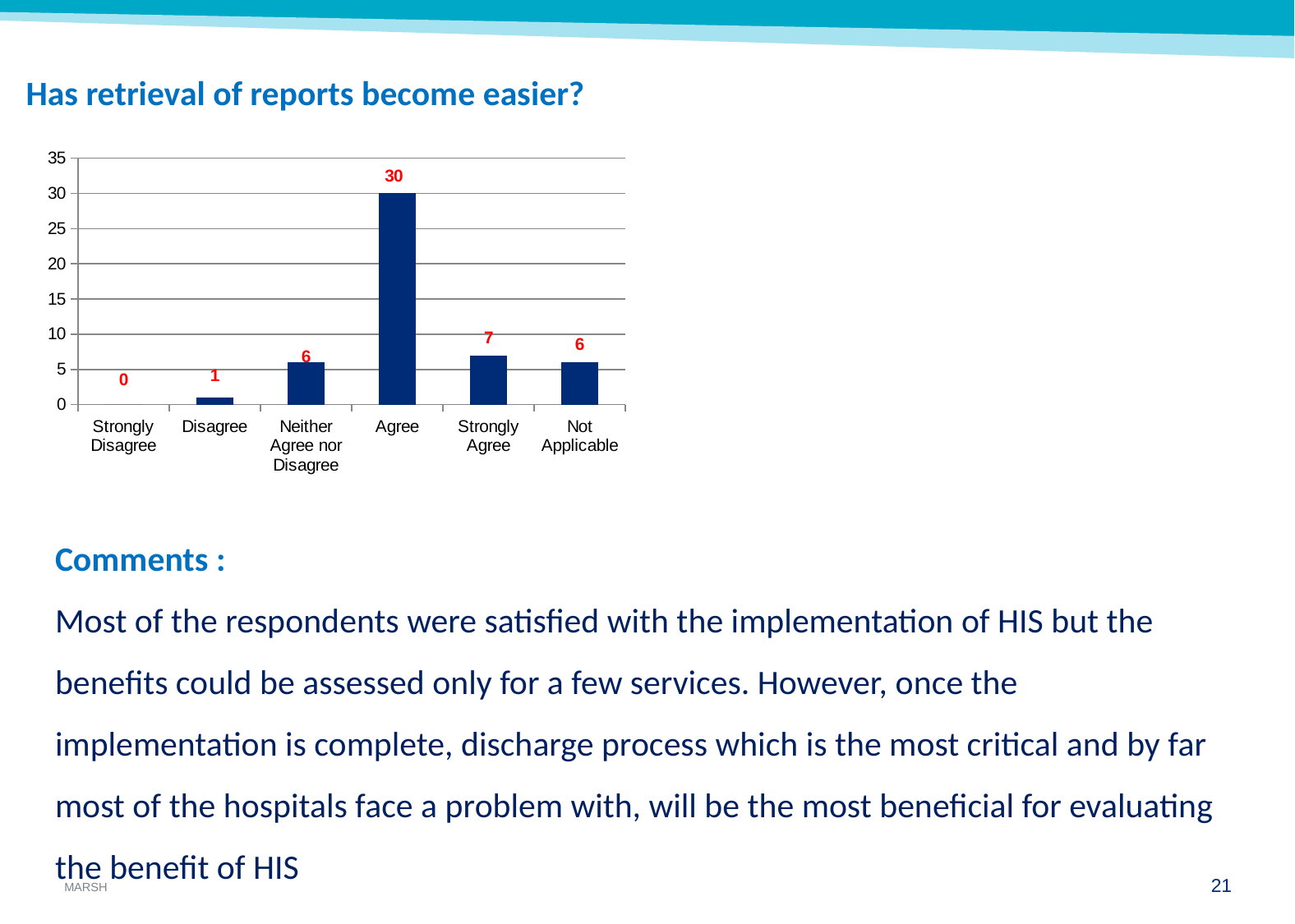
What is the difference between the values for Agree and Strongly Agree? 23 What is the value for Strongly Agree? 7 Which category has the highest value? Agree What is the value for Disagree? 1 Is the value for Agree greater or less than 25? greater Which is larger, the value for Strongly Agree or the value for Neither Agree nor Disagree? Strongly Agree What kind of chart is shown on the slide? bar chart What is the value for Agree? 30 What is the value for Strongly Disagree? 0 How many categories are shown on the x axis? 6 What is the value for Not Applicable? 6 Which category has the lowest value? Strongly Disagree